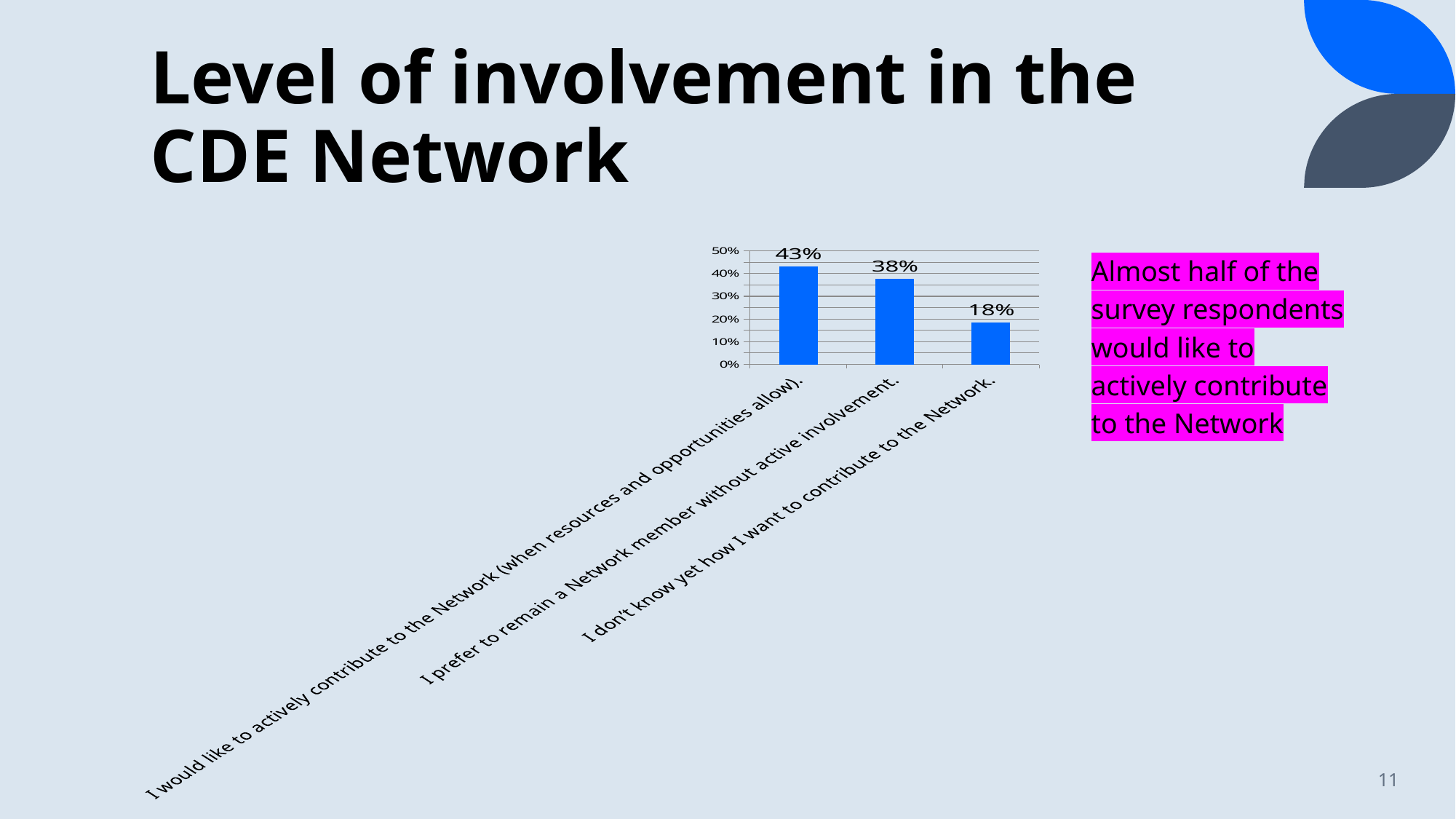
What type of chart is shown on the slide? Bar chart Which response option has the lowest percentage? I don't know yet how I want to contribute to the Network. What percentage of respondents prefer to remain a Network member without active involvement? 38% How many response categories are shown in the chart? 3 What percentage of respondents don't know yet how they want to contribute to the Network? 18% What is the maximum value shown on the chart's vertical axis? 50% What percentage of respondents said they would like to actively contribute to the Network (when resources and opportunities allow)? 43% Which is larger: the percentage who prefer to remain a member without active involvement, or the percentage who don't know yet how they want to contribute? I prefer to remain a Network member without active involvement. What is the difference in percentage points between those who would like to actively contribute and those who prefer to remain a member without active involvement? 5 percentage points Which response option has the highest percentage? I would like to actively contribute to the Network (when resources and opportunities allow). Is the value for 'I don't know yet how I want to contribute to the Network' greater or less than 20%? less What is the difference in percentage points between those who prefer to remain a member without active involvement and those who don't know yet how they want to contribute? 20 percentage points